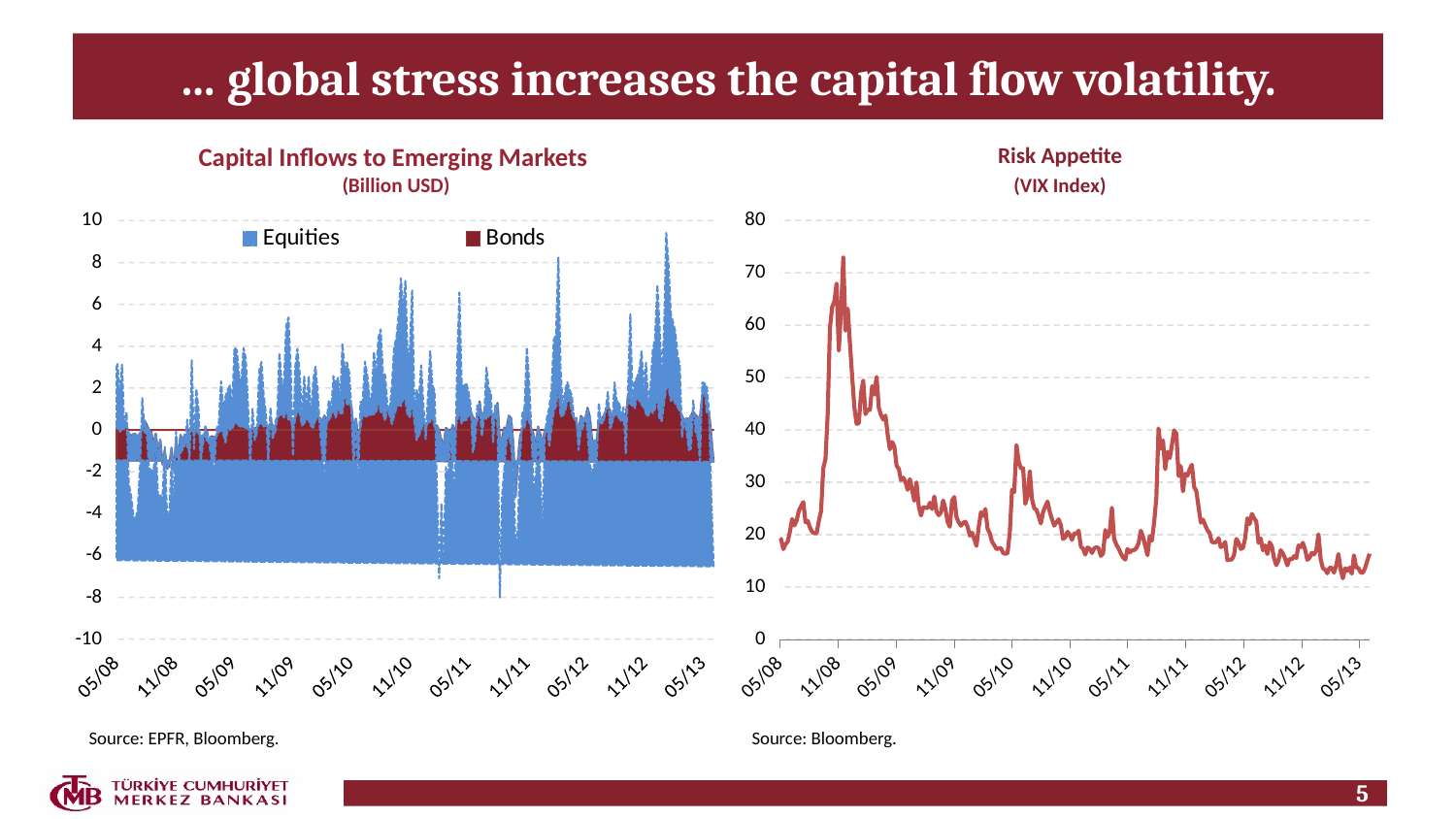
In the 'Risk Appetite (VIX Index)' chart, is the VIX higher at 11/08 or at 11/12? 11/08 In the 'Risk Appetite (VIX Index)' chart, around which x-axis date does the VIX reach its highest value? 11/08 What is the maximum value shown on the y-axis of the 'Risk Appetite (VIX Index)' chart? 80 What kind of chart is the 'Risk Appetite (VIX Index)' chart on the right? line chart What are the two series named in the legend of the 'Capital Inflows to Emerging Markets' chart? Equities and Bonds In the 'Capital Inflows to Emerging Markets' chart, which colour represents Bonds? dark red In the 'Risk Appetite (VIX Index)' chart, is the peak value of the VIX greater or less than 60? greater In the 'Risk Appetite (VIX Index)' chart, is the VIX value at 05/08 greater or less than 40? less In the 'Risk Appetite (VIX Index)' chart, is the VIX value at 05/13 greater or less than 20? less How many series does the legend of the 'Capital Inflows to Emerging Markets' chart list? 2 In the 'Risk Appetite (VIX Index)' chart, does the VIX rise or fall between 11/08 and 05/09? fall